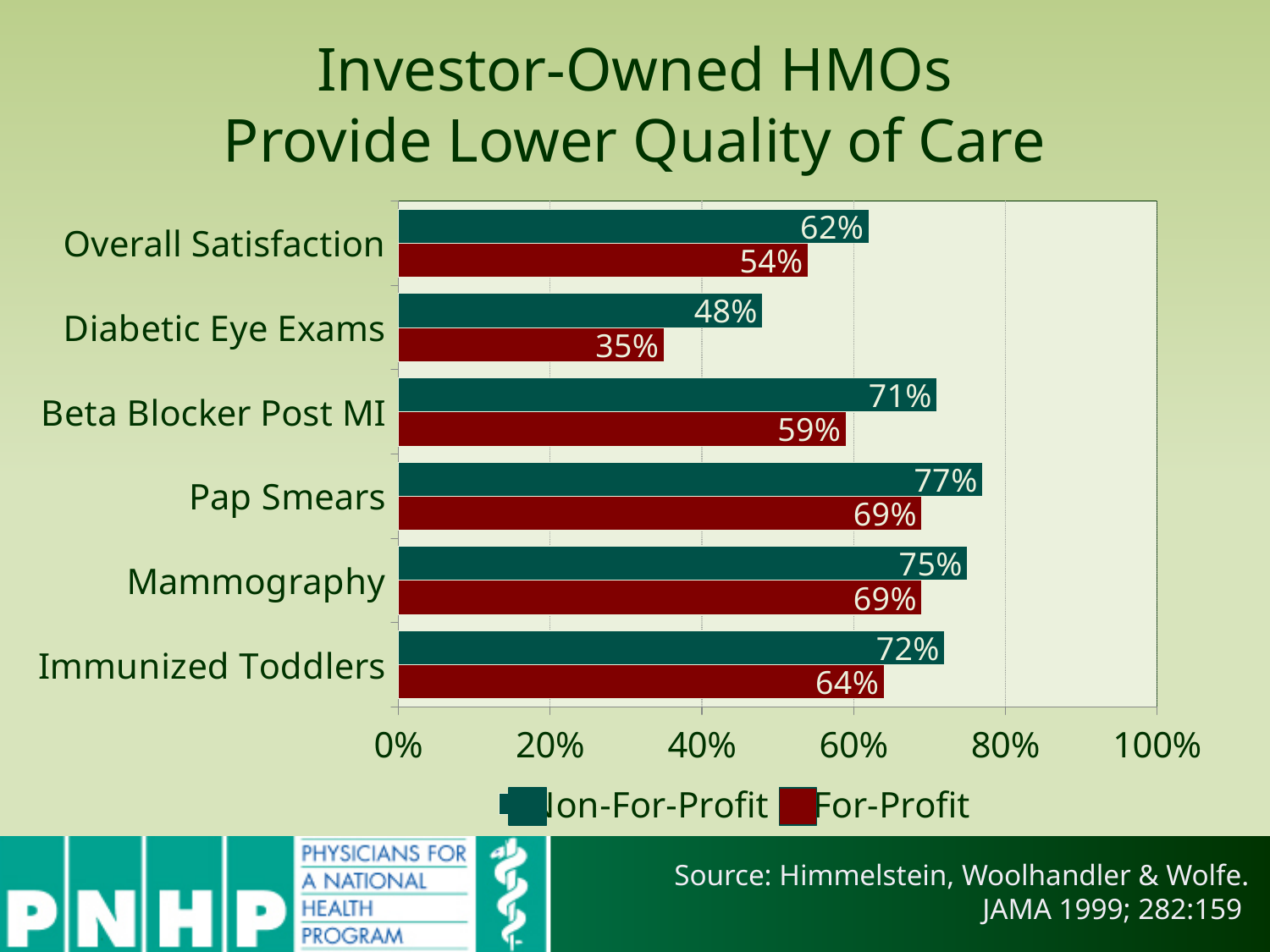
What is the For-Profit value for Beta Blocker Post MI? 59% Which is larger, the For-Profit value for Pap Smears or the For-Profit value for Immunized Toddlers? Pap Smears Which category has the highest Non-For-Profit value? Pap Smears What is the difference between the Non-For-Profit and For-Profit values for Diabetic Eye Exams? 13% What is the difference between the Non-For-Profit and For-Profit values for Overall Satisfaction? 8% What kind of chart is shown on the slide? Bar chart What is the Non-For-Profit value for Diabetic Eye Exams? 48% How many categories are shown on the chart? 6 What is the title of the slide? Investor-Owned HMOs Provide Lower Quality of Care How many series does the legend list? 2 Which category has the lowest For-Profit value? Diabetic Eye Exams What is the For-Profit value for Immunized Toddlers? 64%